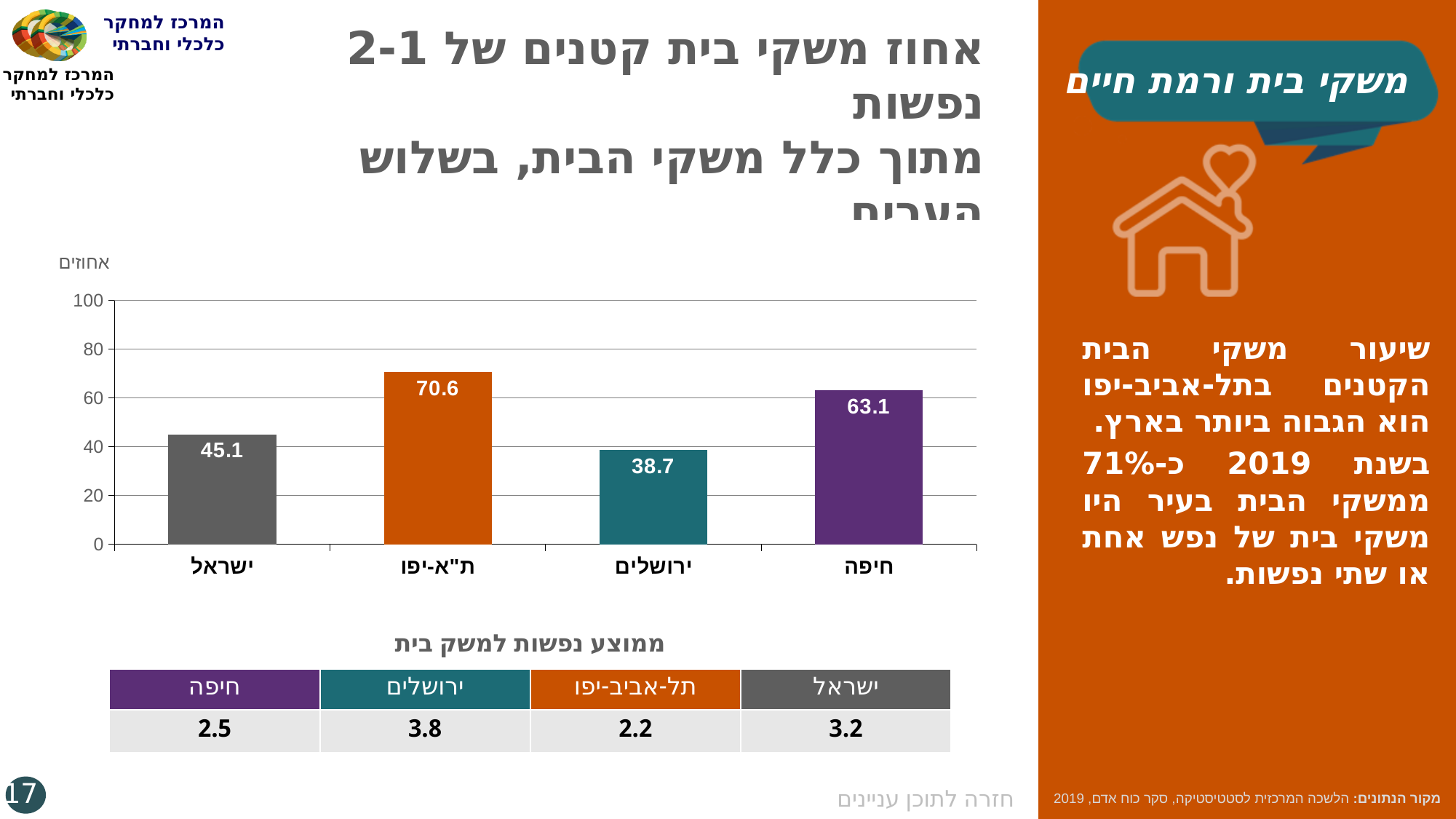
What is the value for ירושלים in the bar chart? 38.7 What is the difference between the values for ת"א-יפו and ירושלים? 31.9 Which category has the lowest value in the bar chart? ירושלים Which category has the highest value in the bar chart? ת"א-יפו Which is larger, the value for חיפה or the value for ישראל? חיפה What is the value for ת"א-יפו in the bar chart? 70.6 What is the label on the vertical axis of the chart? אחוזים What is the value for חיפה in the bar chart? 63.1 How many categories are shown in the bar chart? 4 What is the value for ישראל in the bar chart? 45.1 What is the difference between the values for חיפה and ישראל? 18 What kind of chart is shown on the slide? bar chart